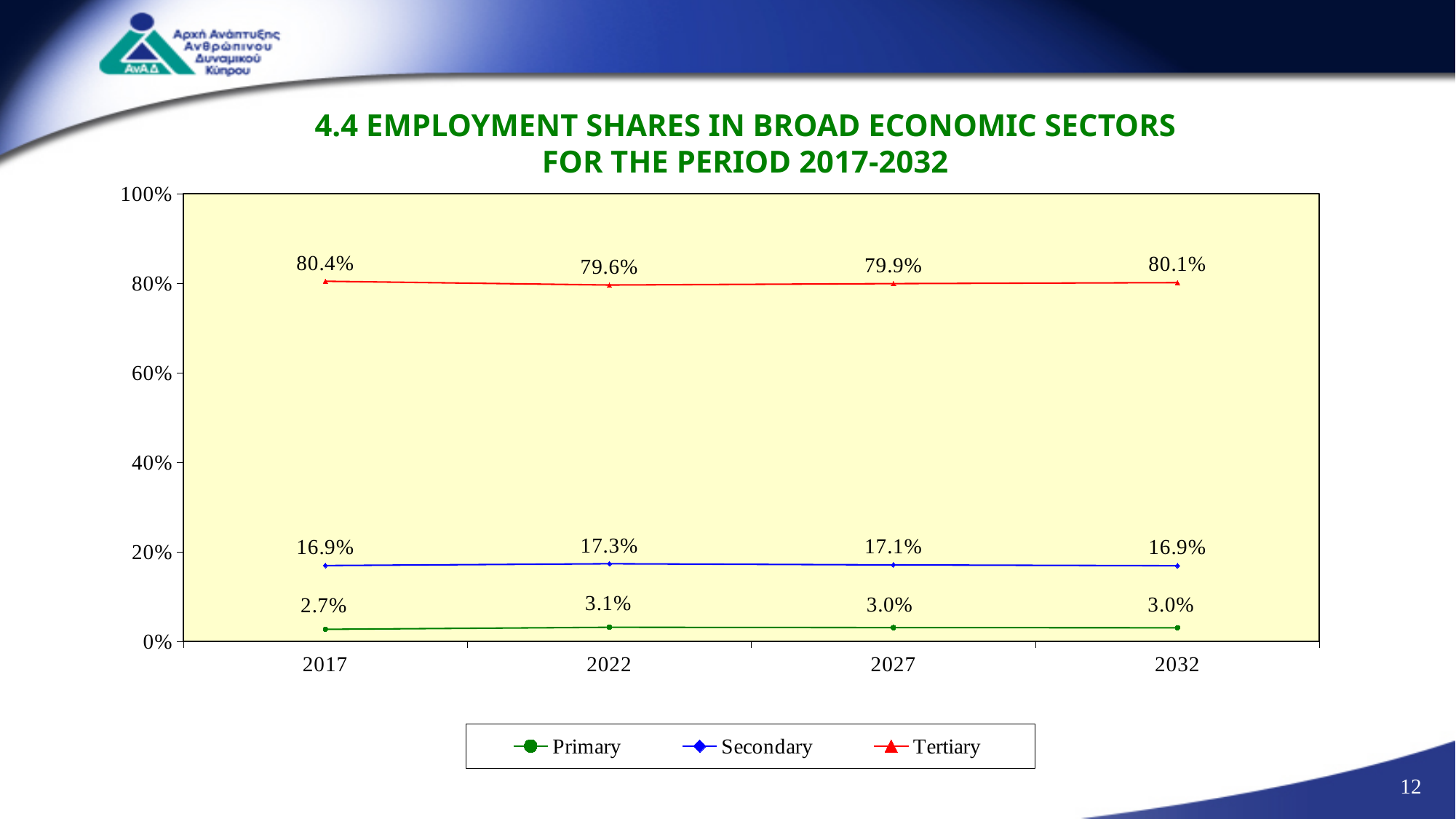
How many series does the legend list? 3 How many years are shown on the x axis? 4 Which sector has the larger employment share in 2027, Secondary or Primary? Secondary In which year is the Tertiary sector's employment share lowest? 2022 Is the Secondary sector's share in 2032 greater or less than 20%? less What is the employment share of the Tertiary sector in 2017? 80.4% In which year is the Secondary sector's employment share highest? 2022 What is the employment share of the Secondary sector in 2022? 17.3% What kind of chart is shown on the slide? line chart What is the difference between the Primary share in 2022 and in 2017? 0.4% What is the difference between the Tertiary share in 2017 and in 2022? 0.8% What is the employment share of the Primary sector in 2032? 3.0%